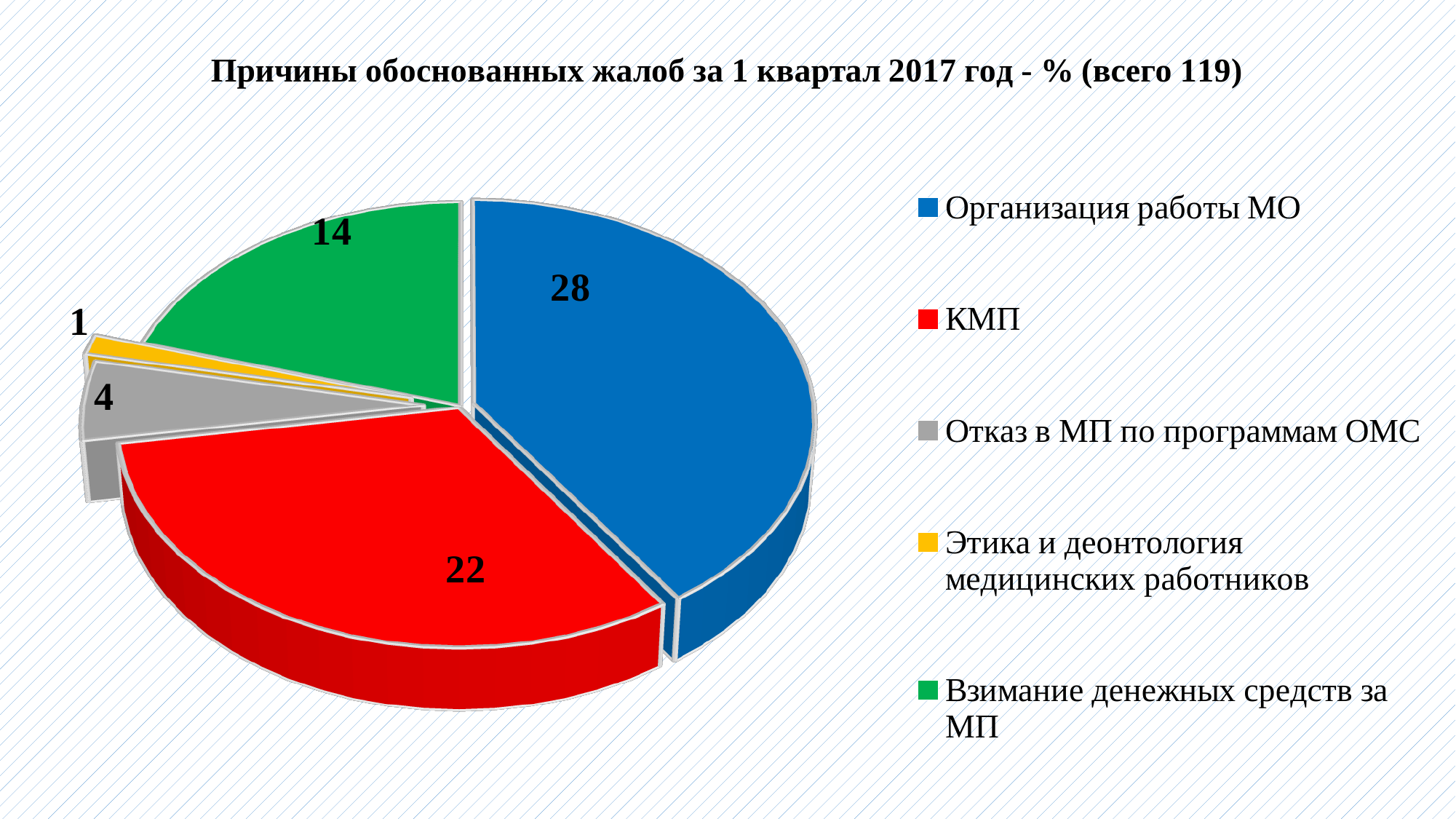
Which category has the largest slice? Организация работы МО What is the value for Взимание денежных средств за МП? 14 Which is larger, the value for Взимание денежных средств за МП or the value for Отказ в МП по программам ОМС? Взимание денежных средств за МП What is the value for Этика и деонтология медицинских работников? 1 Which category has the smallest slice? Этика и деонтология медицинских работников What is the difference between the values for Организация работы МО and КМП? 6 How many categories does the pie chart have? 5 What is the value for Отказ в МП по программам ОМС? 4 What is the value for КМП? 22 What colour is the slice for КМП? red What type of chart is shown on the slide? pie chart What is the value for Организация работы МО? 28